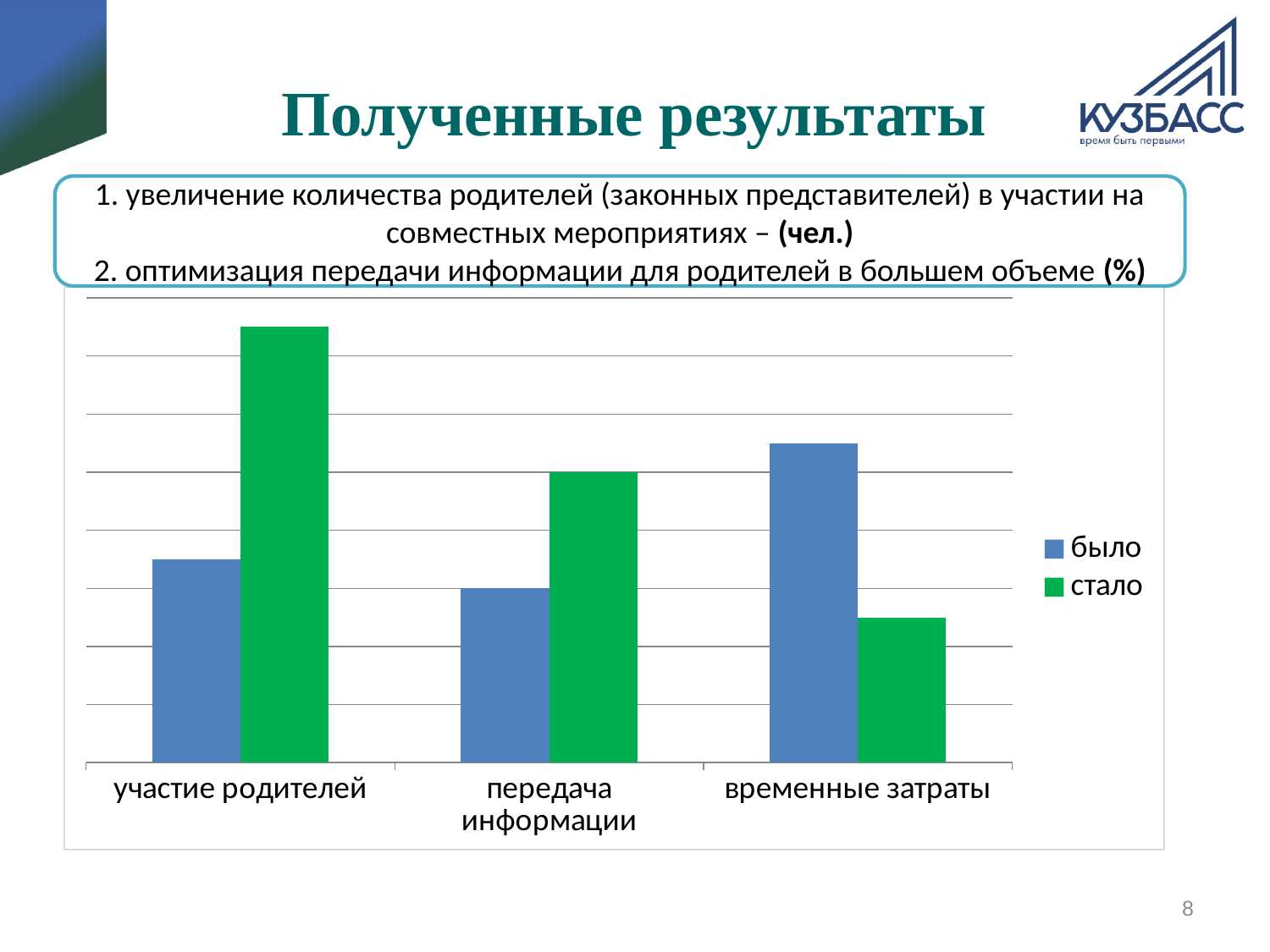
Which category has the lowest "стало" bar? временные затраты How many series does the chart's legend list? 2 Which category has the highest "было" bar? временные затраты Which category has the highest "стало" bar? участие родителей For "участие родителей", which is larger: "было" or "стало"? стало What kind of chart is shown on the slide? bar chart For "временные затраты", which is larger: "было" or "стало"? было Which bar is the tallest in the whole chart? стало for участие родителей How many categories are shown on the x axis of the chart? 3 For "передача информации", which is larger: "было" or "стало"? стало What are the two series named in the chart's legend? было, стало Which colour represents the series "стало" in the chart? green